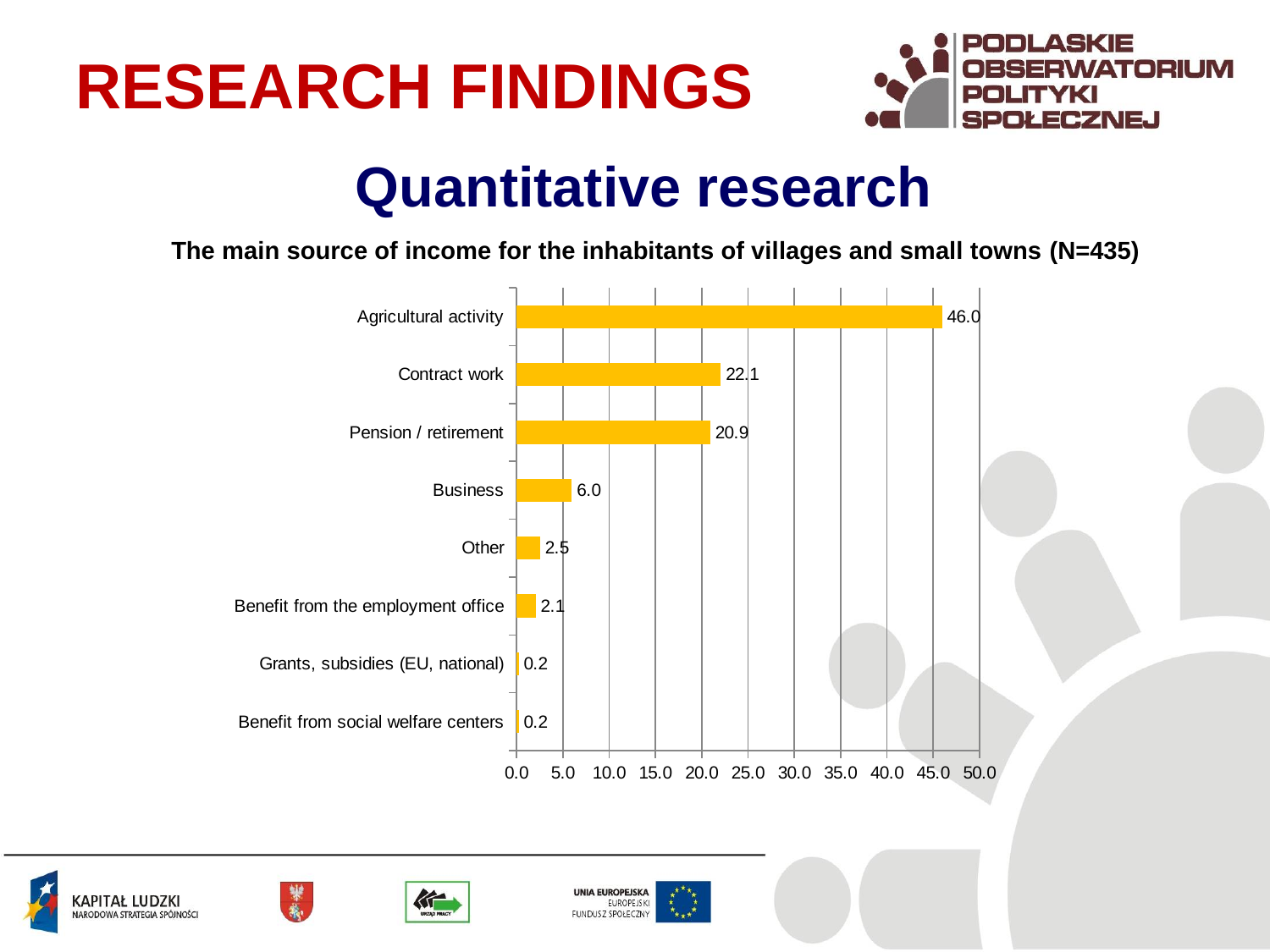
Which is larger, the value for Business or the value for Other? Business What kind of chart is shown on the slide? Bar chart How many categories are shown in the chart? 8 What is the value for Grants, subsidies (EU, national)? 0.2 What is the difference between the values for Contract work and Pension / retirement? 1.2 What is the sample size (N) stated in the chart title? 435 What is the value for Pension / retirement? 20.9 Is the value for Contract work greater or less than 20.0? greater Which category has the highest value? Agricultural activity What is the value for Agricultural activity? 46.0 What is the value for Benefit from the employment office? 2.1 What is the difference between the values for Agricultural activity and Business? 40.0